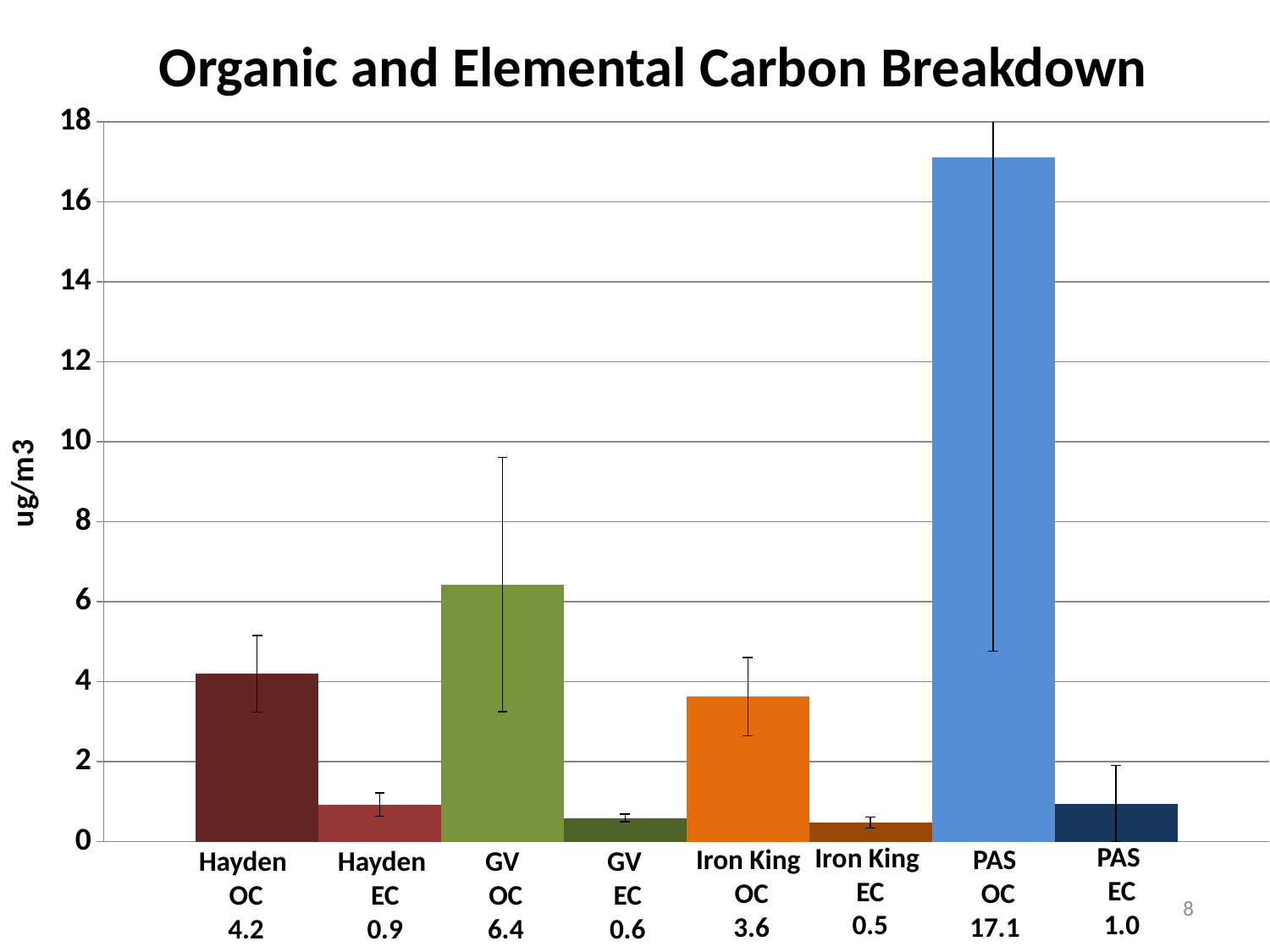
What is the title of the chart? Organic and Elemental Carbon Breakdown Which category has the lowest value? Iron King EC What is the value for Hayden OC? 4.2 What is the value for GV OC? 6.4 What is the value for Iron King EC? 0.5 What is the difference between Hayden OC and Hayden EC? 3.3 Which is larger, GV OC or Iron King OC? GV OC Which category has the highest value? PAS OC What is the value for PAS OC? 17.1 How many bars are shown in the chart? 8 What is the difference between PAS OC and GV OC? 10.7 What kind of chart is this? Bar chart